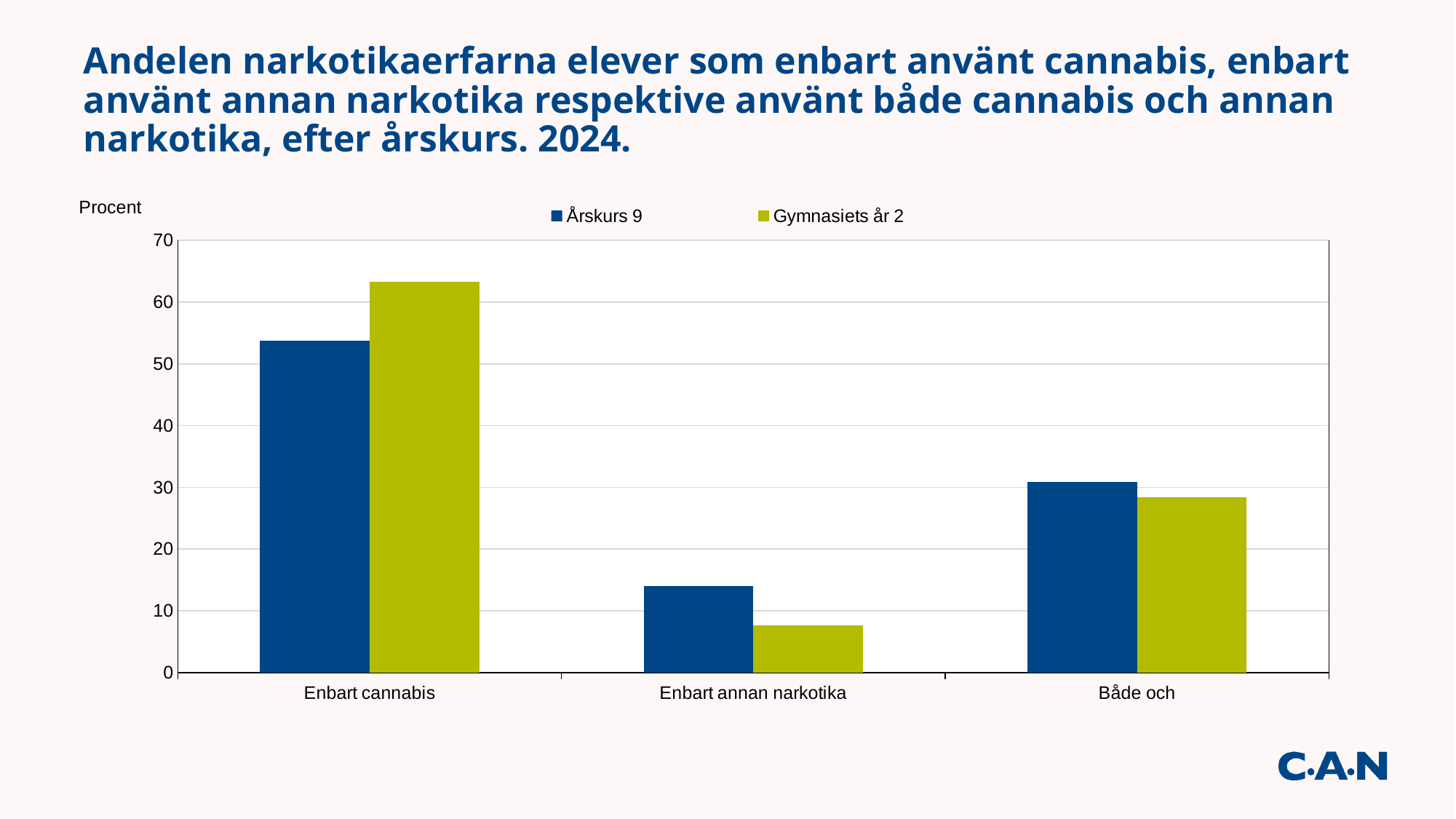
What unit is shown on the y axis label? Procent Which category has the lowest value for Gymnasiets år 2? Enbart annan narkotika How many series does the legend list? 2 Is the value for Årskurs 9 in Enbart cannabis greater or less than 50? greater Is the value for Gymnasiets år 2 in Enbart cannabis greater or less than 60? greater How many categories are shown on the x axis? 3 Is the value for Gymnasiets år 2 in Enbart annan narkotika greater or less than 10? less What kind of chart is shown on the slide? bar chart For Enbart cannabis, which series has the larger value, Årskurs 9 or Gymnasiets år 2? Gymnasiets år 2 For Enbart annan narkotika, which series has the larger value, Årskurs 9 or Gymnasiets år 2? Årskurs 9 Which category has the highest value for Årskurs 9? Enbart cannabis